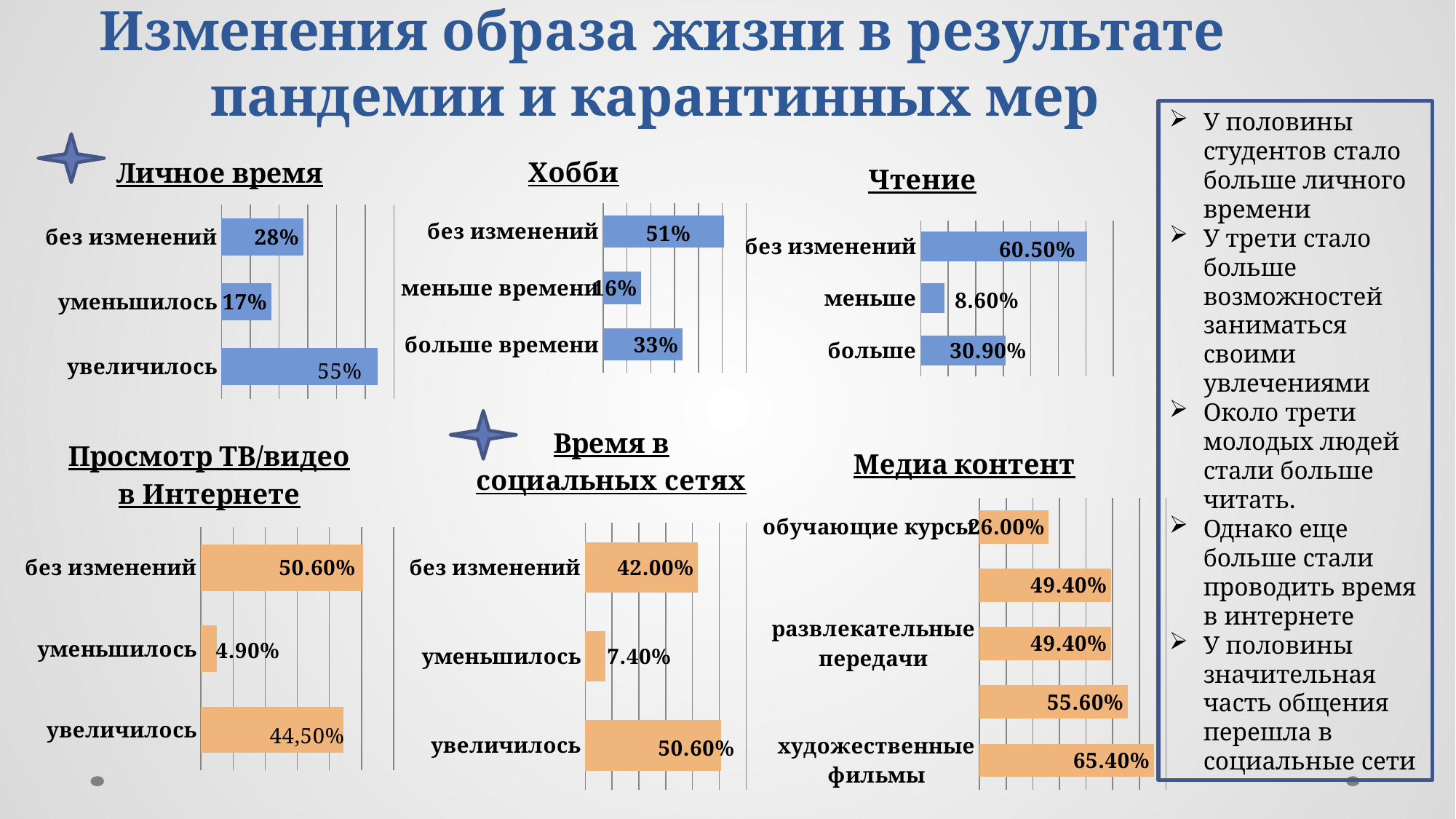
In the 'Личное время' chart, what is the value for 'увеличилось'? 55% In the 'Хобби' chart, what is the value for 'больше времени'? 33% In the 'Чтение' chart, which category has the highest value? без изменений In the 'Просмотр ТВ/видео в Интернете' chart, which is larger: 'без изменений' or 'увеличилось'? без изменений How many bars does the 'Медиа контент' chart have? 5 In the 'Личное время' chart, which category has the lowest value? уменьшилось In the 'Время в социальных сетях' chart, what is the value for 'увеличилось'? 50.60% In the 'Чтение' chart, what is the value for 'меньше'? 8.60% In the 'Просмотр ТВ/видео в Интернете' chart, what is the value for 'уменьшилось'? 4.90% In the 'Хобби' chart, what is the difference between 'без изменений' and 'меньше времени'? 35% In the 'Медиа контент' chart, what is the value for 'художественные фильмы'? 65.40% In the 'Время в социальных сетях' chart, what is the difference between 'увеличилось' and 'уменьшилось'? 43.20%